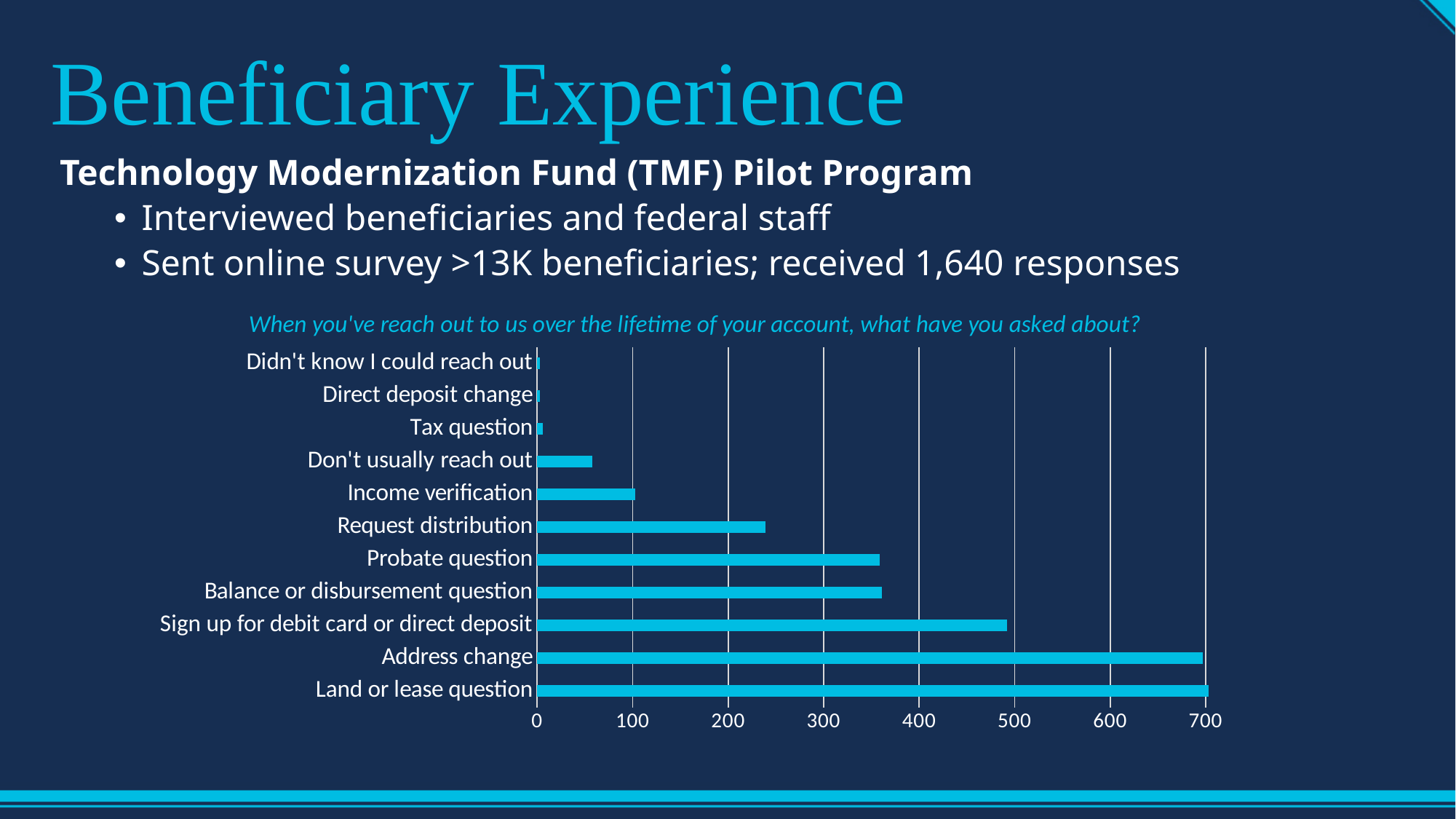
Is the value for "Request distribution" greater or less than 200? greater Which is larger, the value for "Sign up for debit card or direct deposit" or the value for "Request distribution"? Sign up for debit card or direct deposit Is the value for "Request distribution" greater or less than 300? less Is the value for "Balance or disbursement question" greater or less than 300? greater What kind of chart is shown on the slide? bar chart What is the highest value shown on the chart's horizontal axis? 700 How many categories are plotted in the chart? 11 Which is larger, the value for "Income verification" or the value for "Don't usually reach out"? Income verification What is the title of the chart? When you've reach out to us over the lifetime of your account, what have you asked about?